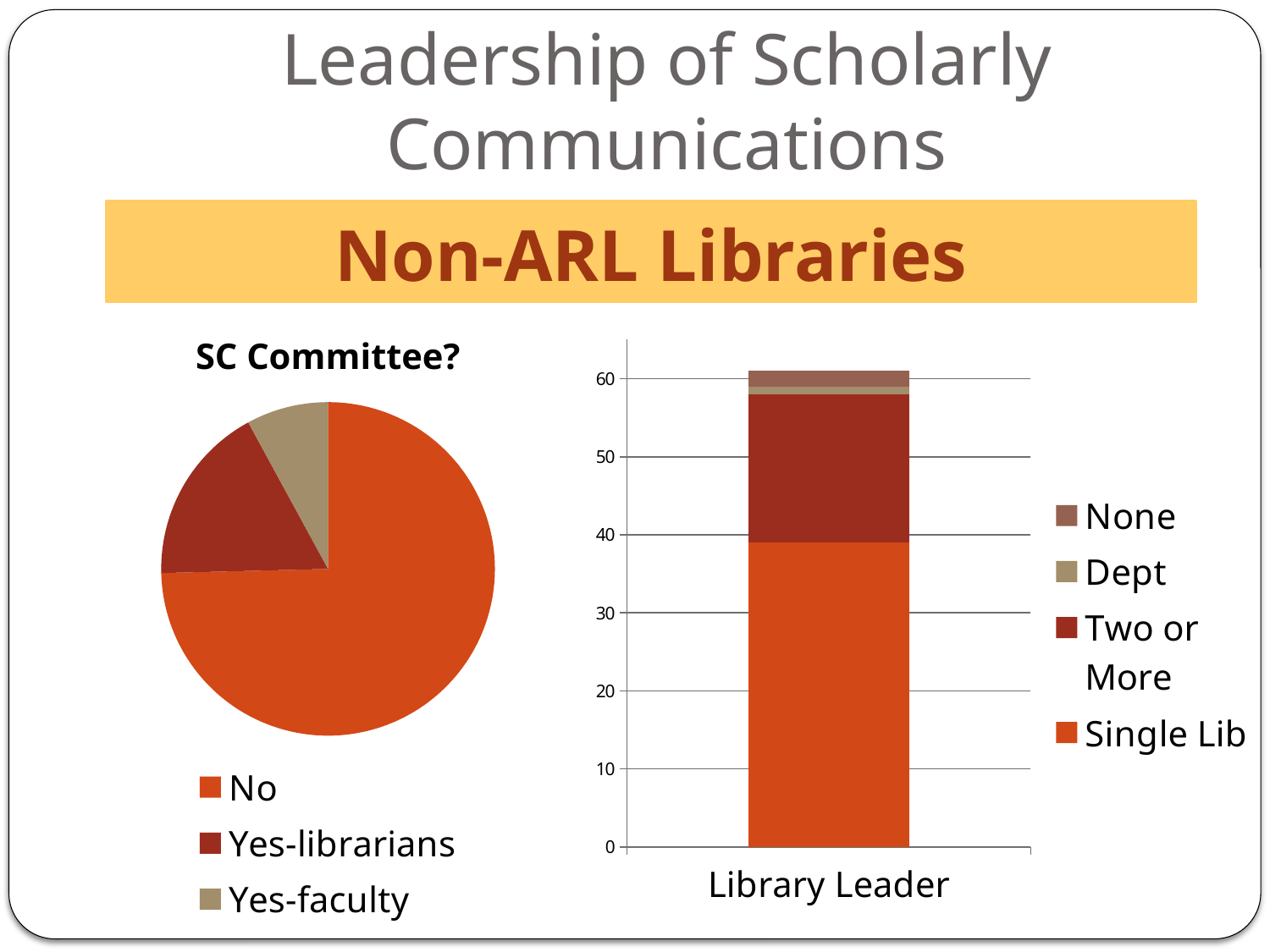
In the bar chart on the right, is the value for Single Lib greater or less than 50? less In the bar chart on the right, how many series does the legend list? 4 In the bar chart on the right, which series makes up the largest segment of the Library Leader bar? Single Lib In the bar chart on the right, how many categories are shown on the x axis? 1 In the "SC Committee?" pie chart, which category has the smallest slice? Yes-faculty In the "SC Committee?" pie chart, which category has the largest slice? No What kind of chart is the chart on the right with the "Library Leader" category? stacked bar chart In the "SC Committee?" pie chart, which slice is larger, Yes-librarians or Yes-faculty? Yes-librarians In the "SC Committee?" pie chart, how many slices are there? 3 What is the category label on the x axis of the bar chart on the right? Library Leader What kind of chart is the chart titled "SC Committee?"? pie chart In the bar chart on the right, is the value for Single Lib greater or less than 30? greater